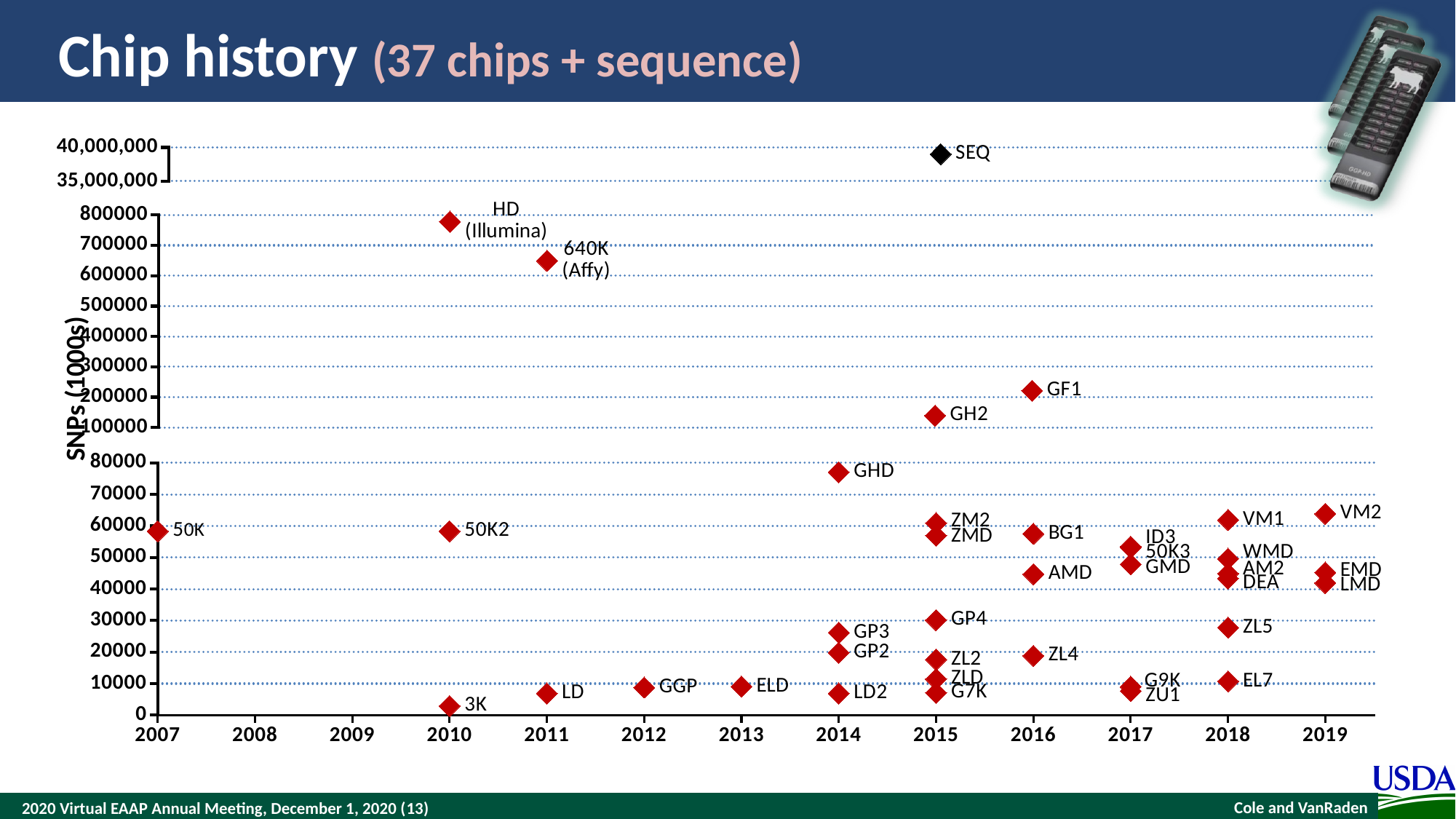
What kind of chart is shown on the slide? scatter chart Is the value for 3K greater or less than 10000? less How many points are plotted for the year 2015? 8 Which point has the highest number of SNPs? SEQ Which has more SNPs, ZL5 or ZL4? ZL5 Is the value for GHD greater or less than 70000? greater What is the label of the y axis? SNPs (1000s) Is the value for GF1 greater or less than 200000? greater Which has more SNPs, HD (Illumina) or 640K (Affy)? HD (Illumina) Which has more SNPs, GP3 or GP2? GP3 Which chip has the lowest number of SNPs? 3K